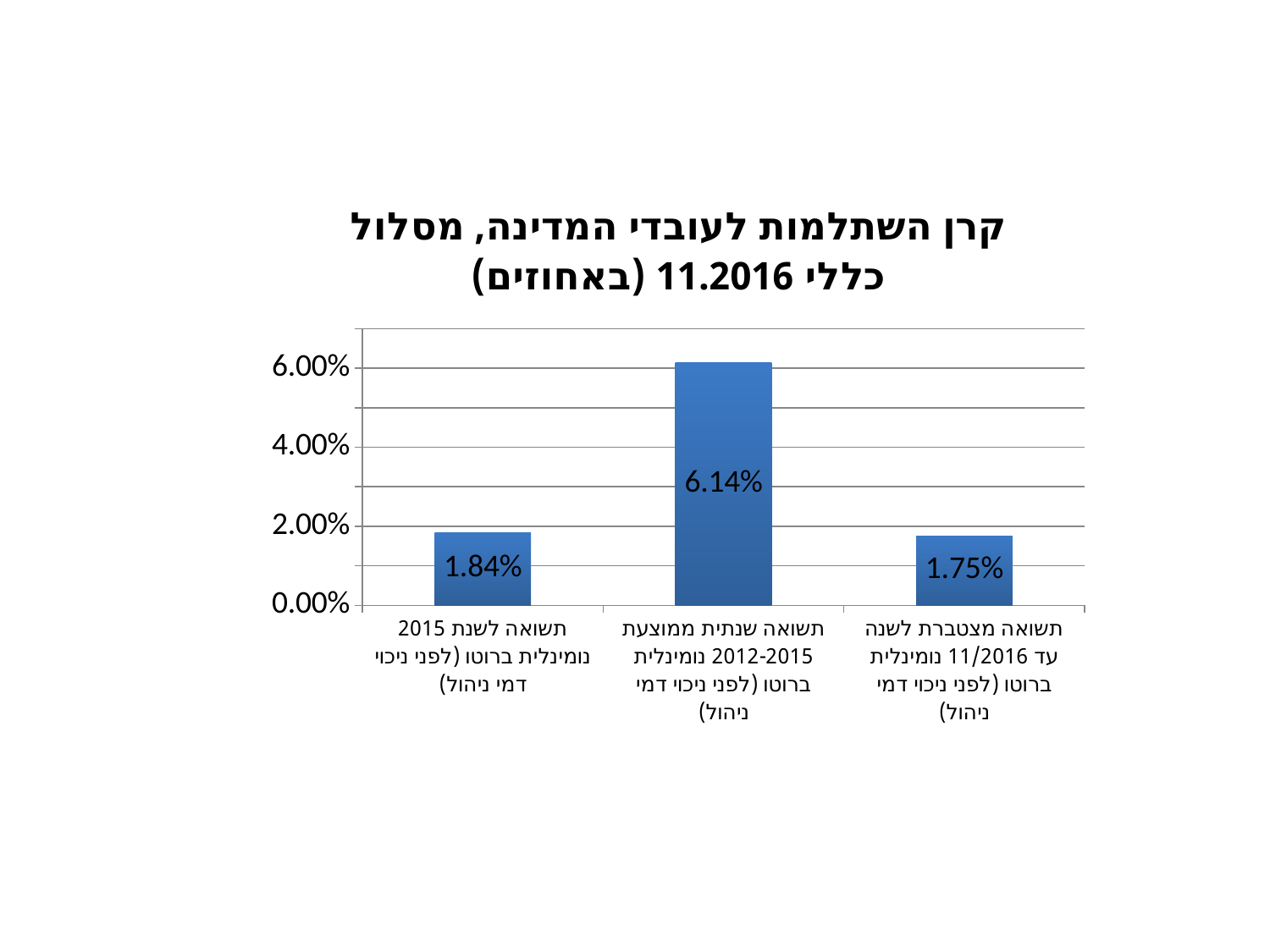
Which is larger: the 2015 return or the average annual return 2012-2015? תשואה שנתית ממוצעת 2012-2015 What is the value for the average annual return 2012-2015 (תשואה שנתית ממוצעת 2012-2015)? 6.14% Which category has the highest value? תשואה שנתית ממוצעת 2012-2015 נומינלית ברוטו (לפני ניכוי דמי ניהול) Is the value for the average annual return 2012-2015 greater or less than 4.00%? greater Which category has the lowest value? תשואה מצטברת לשנה עד 11/2016 נומינלית ברוטו (לפני ניכוי דמי ניהול) What is the value for the cumulative return for the year to 11/2016 (תשואה מצטברת לשנה עד 11/2016)? 1.75% What is the difference between the average annual return 2012-2015 and the 2015 return? 4.30% What kind of chart is shown on the slide? bar chart What is the value for the 2015 return (תשואה לשנת 2015)? 1.84% What is the difference between the 2015 return and the cumulative return to 11/2016? 0.09% How many bars are shown in the chart? 3 What is the title of the chart? קרן השתלמות לעובדי המדינה, מסלול כללי 11.2016 (באחוזים)